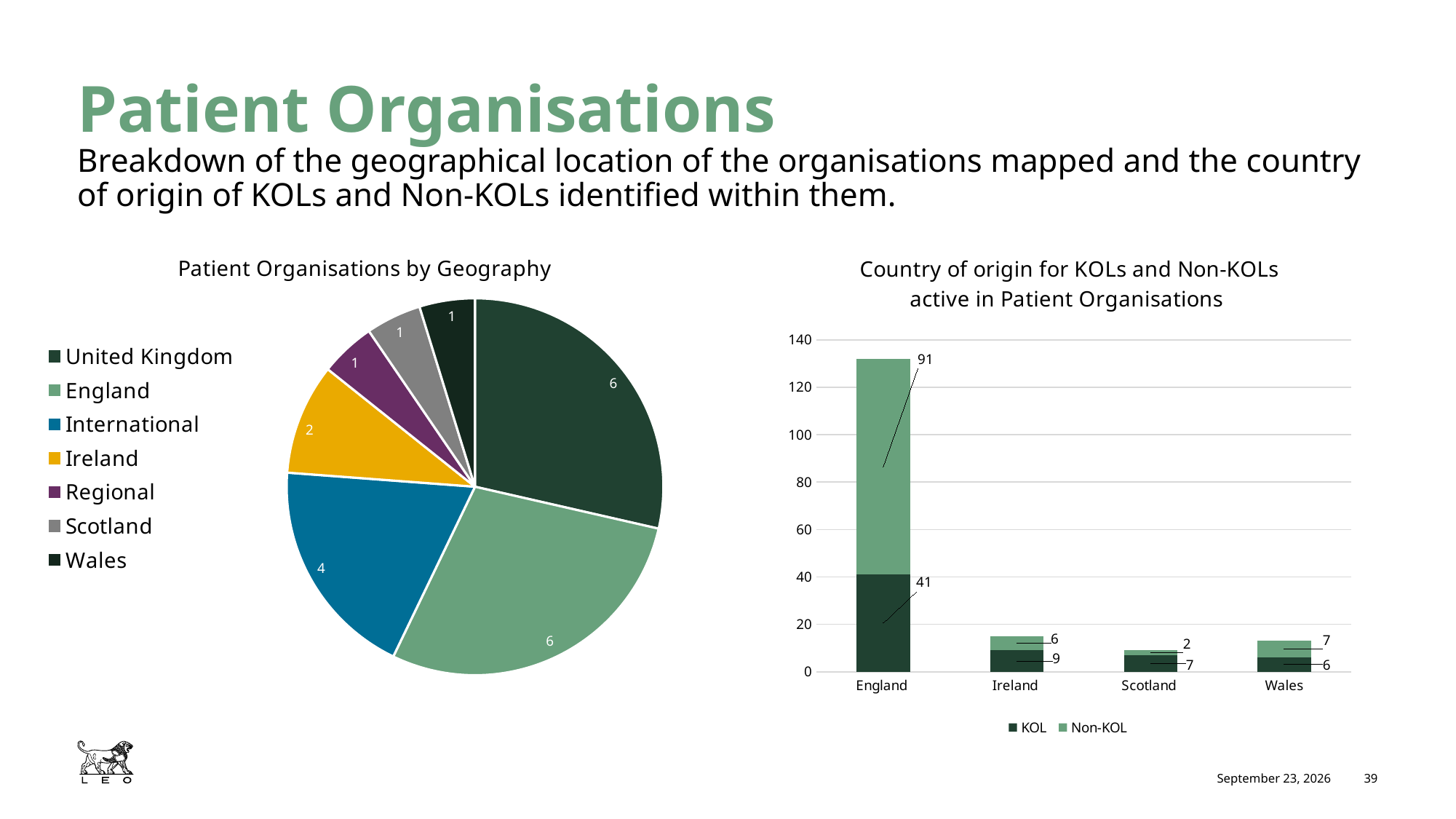
What kind of chart is Country of origin for KOLs and Non-KOLs active in Patient Organisations? bar chart In the Country of origin for KOLs and Non-KOLs chart, what is the KOL value for England? 41 What kind of chart is Patient Organisations by Geography? pie chart In the Country of origin for KOLs and Non-KOLs chart, what is the total of the stacked bar for England? 132 In the Country of origin for KOLs and Non-KOLs chart, what is the Non-KOL value for Scotland? 2 In the Country of origin for KOLs and Non-KOLs chart, which is larger for Ireland, KOL or Non-KOL? KOL In the Patient Organisations by Geography pie chart, which is larger, Ireland or International? International In the Patient Organisations by Geography pie chart, what is the value for International? 4 How many series does the legend of the Country of origin for KOLs and Non-KOLs chart list? 2 How many categories does the Patient Organisations by Geography pie chart show? 7 In the Country of origin for KOLs and Non-KOLs chart, which country has the highest total bar? England In the Country of origin for KOLs and Non-KOLs chart, what is the difference between the Non-KOL values for England and Ireland? 85